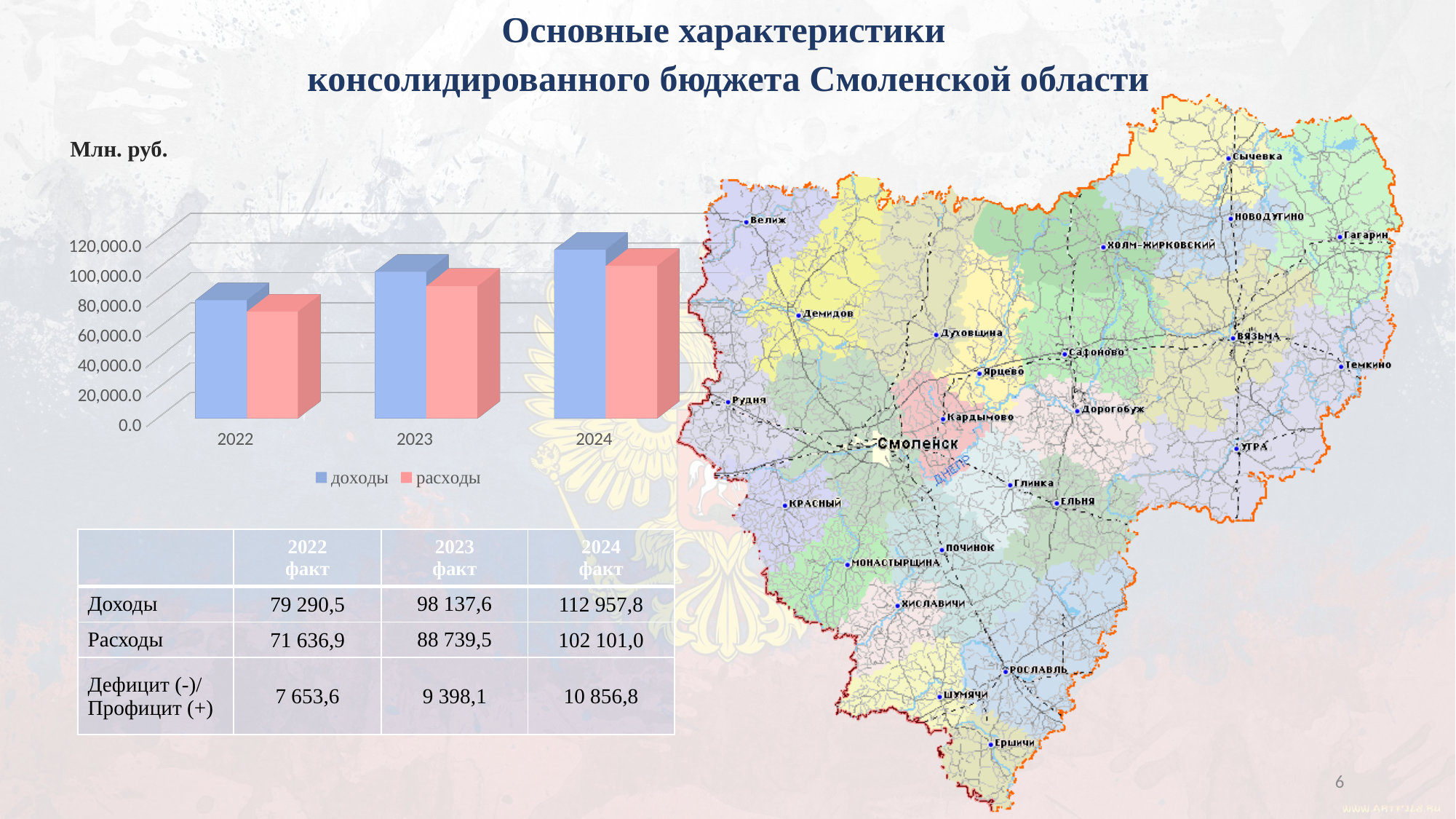
Which year has the highest value for доходы? 2024 Is the value for расходы in 2023 greater or less than 80,000.0? greater Is the value for доходы in 2024 greater or less than 100,000.0? greater What kind of chart is shown on the slide? bar chart What are the two series named in the chart legend? доходы, расходы What unit is indicated above the chart? Млн. руб. Is the value for расходы in 2022 greater or less than 80,000.0? less How many series does the chart legend list? 2 How many years are shown on the x axis of the chart? 3 Do the values for расходы rise or fall from 2022 to 2024? rise